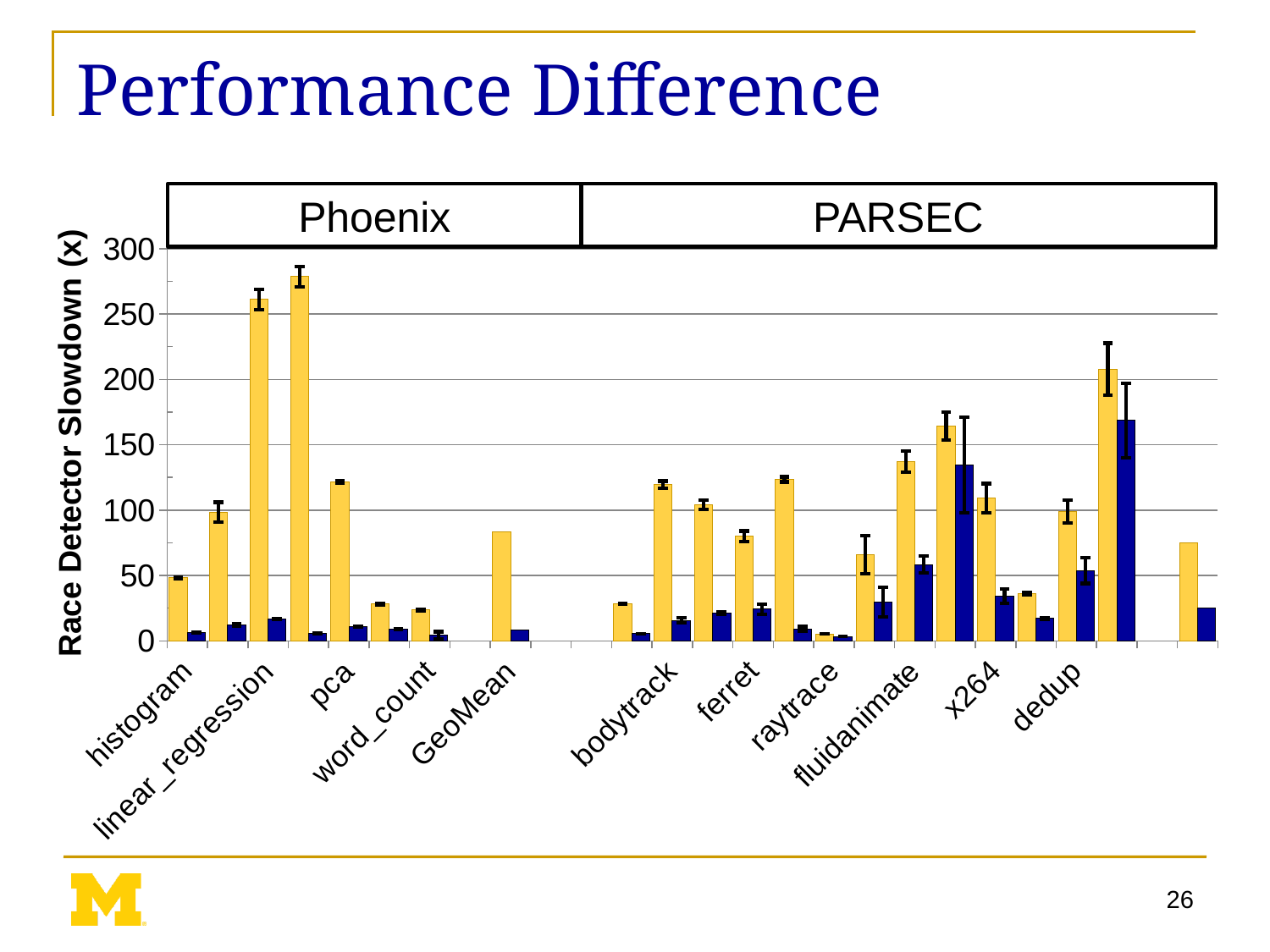
Is the tallest bar in the chart in the Phoenix group or the PARSEC group? Phoenix What are the two benchmark group headings shown above the chart? Phoenix and PARSEC Is the yellow bar for bodytrack greater or less than 50? greater What is the highest value labelled on the vertical axis? 300 For histogram, which bar is taller, the yellow one or the blue one? yellow Is the yellow bar for GeoMean in the Phoenix group greater or less than 50? greater Is the yellow bar for histogram greater or less than 100? less How many category labels are printed along the x axis? 11 What kind of chart is shown on the slide? bar chart What is the title of the vertical axis? Race Detector Slowdown (x)